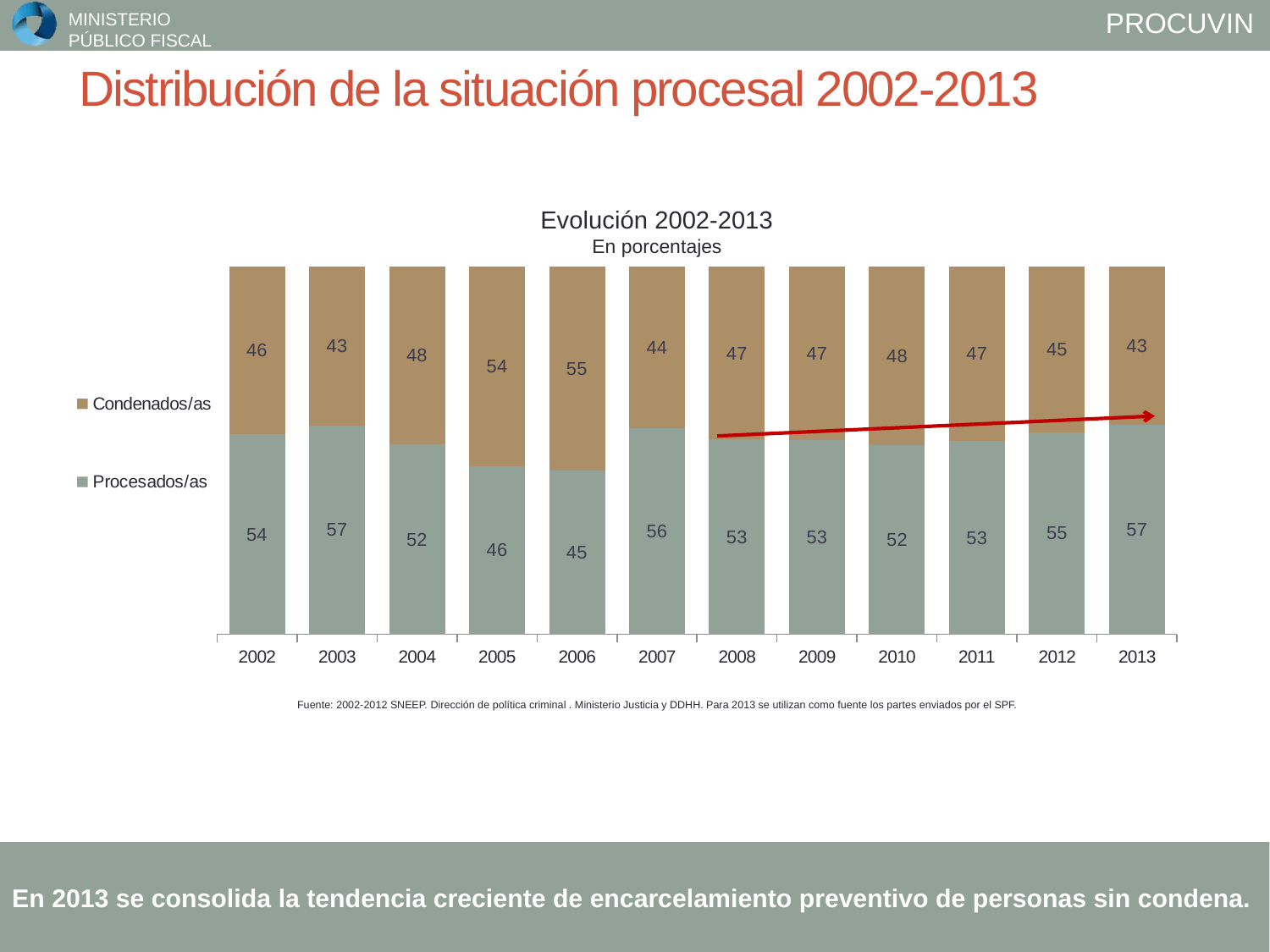
What type of chart is shown on the slide? Stacked bar chart How many series does the legend list? 2 What is the total of the stacked bar for 2005? 100 In which year is the value for Procesados/as lowest? 2006 In which year is the value for Condenados/as highest? 2006 How many years are shown on the x axis? 12 What is the value for Procesados/as in 2013? 57 What is the difference between the Procesados/as values for 2013 and 2006? 12 What is the value for Condenados/as in 2005? 54 What is the subtitle shown under the chart title 'Evolución 2002-2013'? En porcentajes What is the value for Procesados/as in 2006? 45 Which is larger in 2007, Procesados/as or Condenados/as? Procesados/as